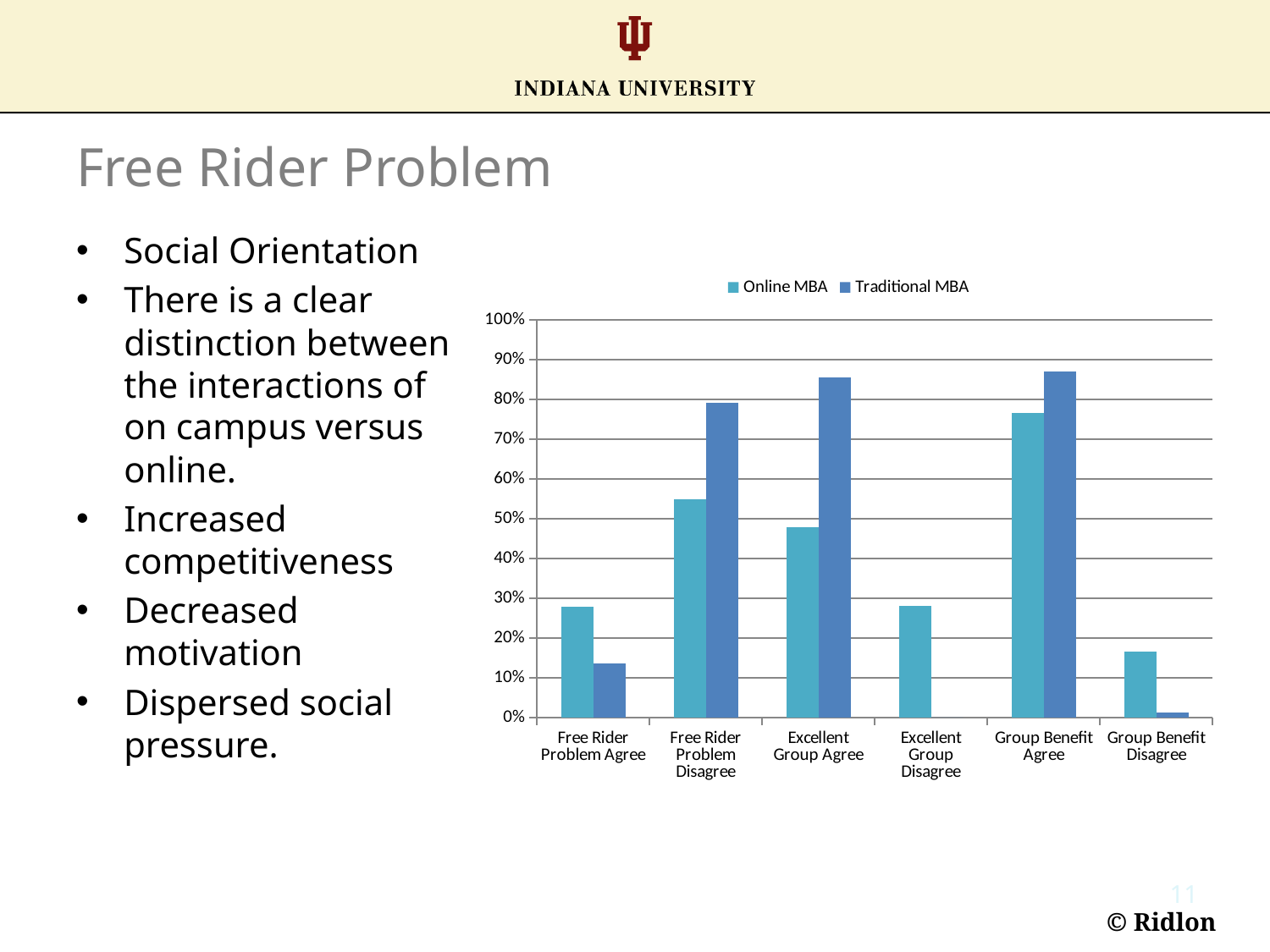
What kind of chart is shown on the slide? bar chart How many categories are shown along the x axis of the chart? 6 Which two series are listed in the chart legend? Online MBA and Traditional MBA For Excellent Group Agree, which series has the larger value, Online MBA or Traditional MBA? Traditional MBA Is the Online MBA value for Free Rider Problem Agree greater or less than 30%? less For Free Rider Problem Agree, which series has the larger value, Online MBA or Traditional MBA? Online MBA Which category has the lowest Online MBA value? Group Benefit Disagree Is the Traditional MBA value for Free Rider Problem Agree greater or less than 20%? less How many series does the chart legend list? 2 Which category has the highest Online MBA value? Group Benefit Agree Is the Online MBA value for Free Rider Problem Disagree greater or less than 50%? greater